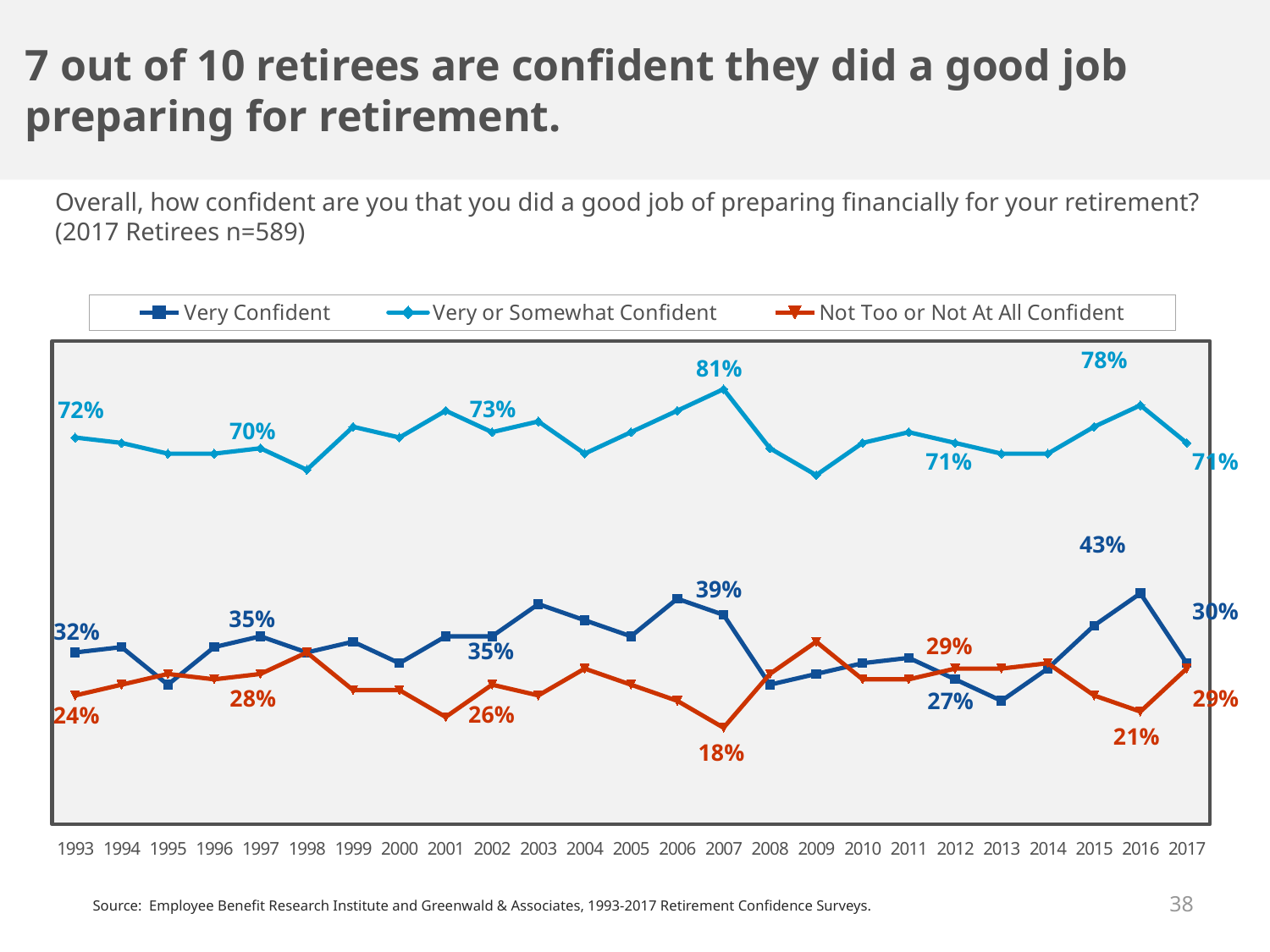
What is the value for Very Confident in 2016? 43% What type of chart is shown on the slide? Line chart In 2012, which is higher: Very Confident or Not Too or Not At All Confident? Not Too or Not At All Confident How many years are shown on the x axis? 25 By how many percentage points did Very or Somewhat Confident fall from 2016 to 2017? 7 percentage points How many series does the legend list? 3 What is the value for Not Too or Not At All Confident in 2007? 18% What is the value for Not Too or Not At All Confident in 2017? 29% What is the value for Very or Somewhat Confident in 2007? 81% By how many percentage points did Very Confident fall from 2016 to 2017? 13 percentage points In which year does the Very or Somewhat Confident line reach its highest point? 2007 What is the value for Very Confident in 1993? 32%